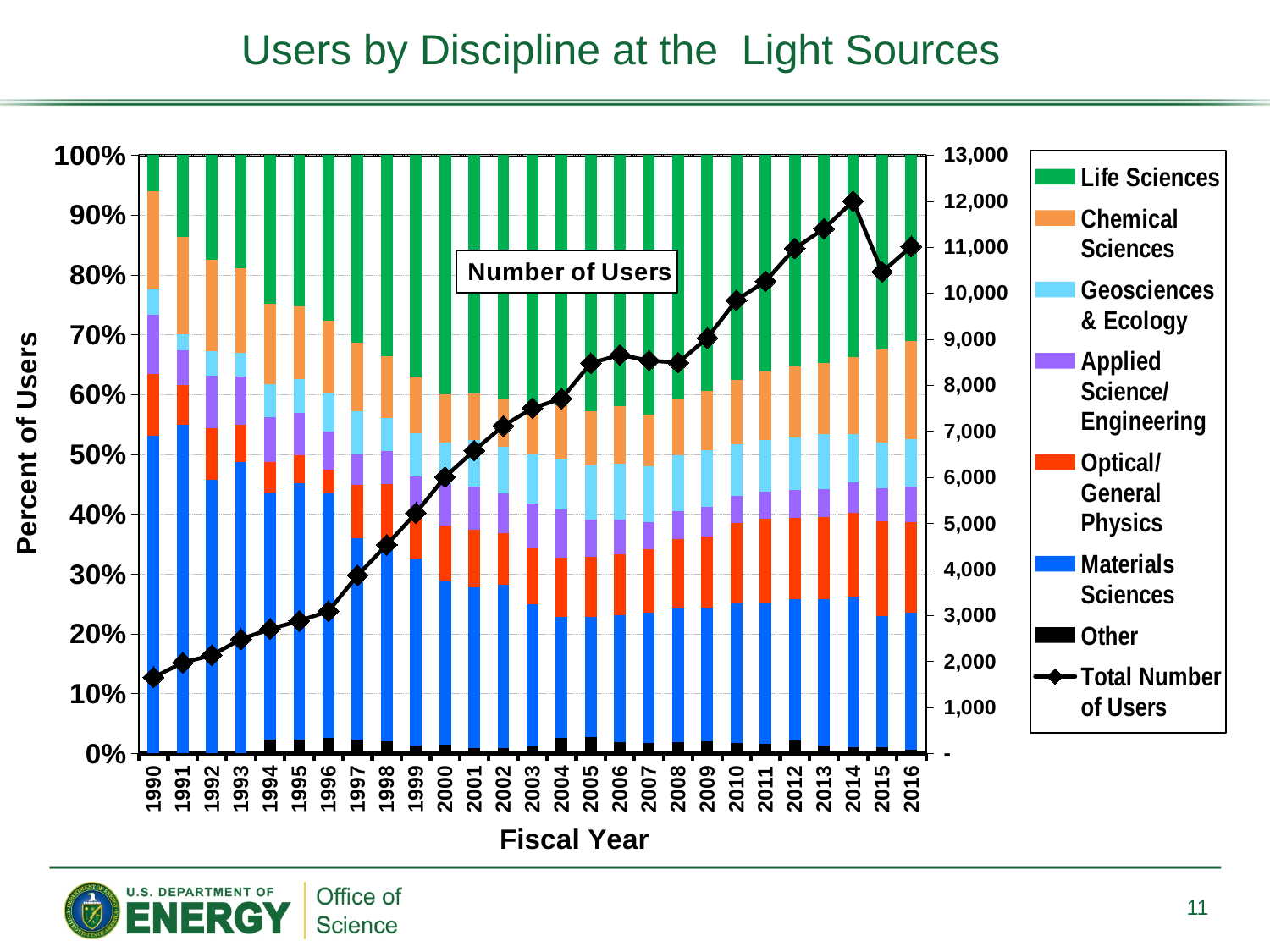
What is the title of the chart on the slide? Users by Discipline at the Light Sources How many series does the legend list? 8 What kind of chart is shown on the slide? Stacked bar chart with a line What is the label of the left vertical axis? Percent of Users Is the Total Number of Users in 1990 greater or less than 2,000? less Which fiscal year has the lowest Total Number of Users? 1990 Does the Total Number of Users generally rise or fall from 1990 to 2016? rise Is the Materials Sciences share of users in 1990 greater or less than 50%? greater How many fiscal years are shown on the x axis of the chart? 27 Is the Total Number of Users in 2005 greater or less than 8,000? greater Which fiscal year has the highest Total Number of Users? 2014